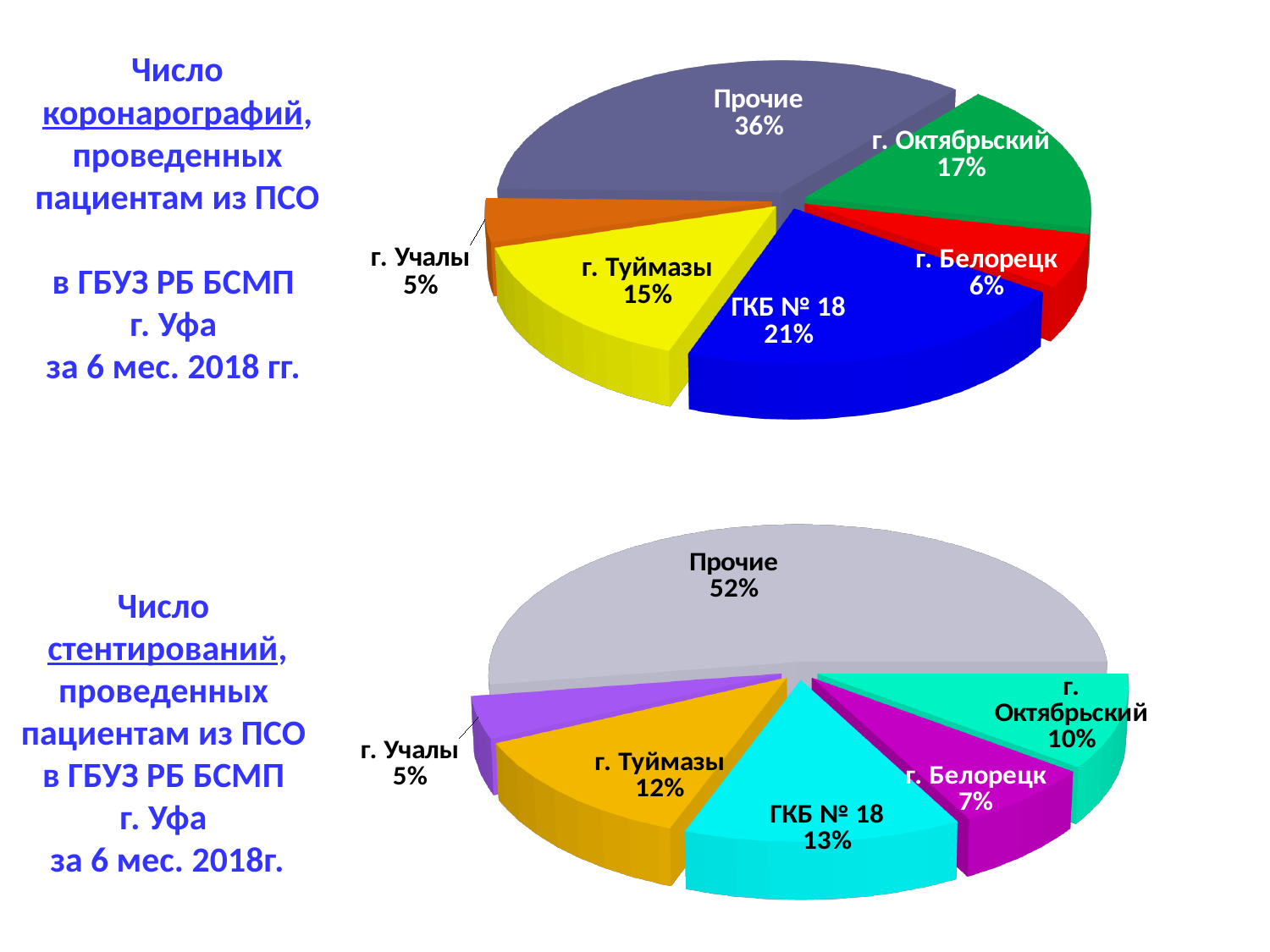
In the bottom pie chart (число стентирований), what share does г. Белорецк have? 7% In the bottom pie chart (число стентирований), which category has the smallest share? г. Учалы In the top pie chart (число коронарографий), what is the difference in percentage points between г. Туймазы and г. Белорецк? 9 What type of chart is the top chart on the slide? Pie chart In the bottom pie chart (число стентирований), what is the difference in percentage points between Прочие and ГКБ № 18? 39 In the top pie chart (число коронарографий), what share does г. Октябрьский have? 17% In the bottom pie chart (число стентирований), which is larger: ГКБ № 18 or г. Туймазы? ГКБ № 18 In the bottom pie chart (число стентирований), what share does Прочие have? 52% In the top pie chart (число коронарографий), which category has the largest share? Прочие In the top pie chart (число коронарографий), what share does ГКБ № 18 have? 21% In the top pie chart (число коронарографий), which category has the smallest share? г. Учалы How many slices does the bottom pie chart (число стентирований) have? 6